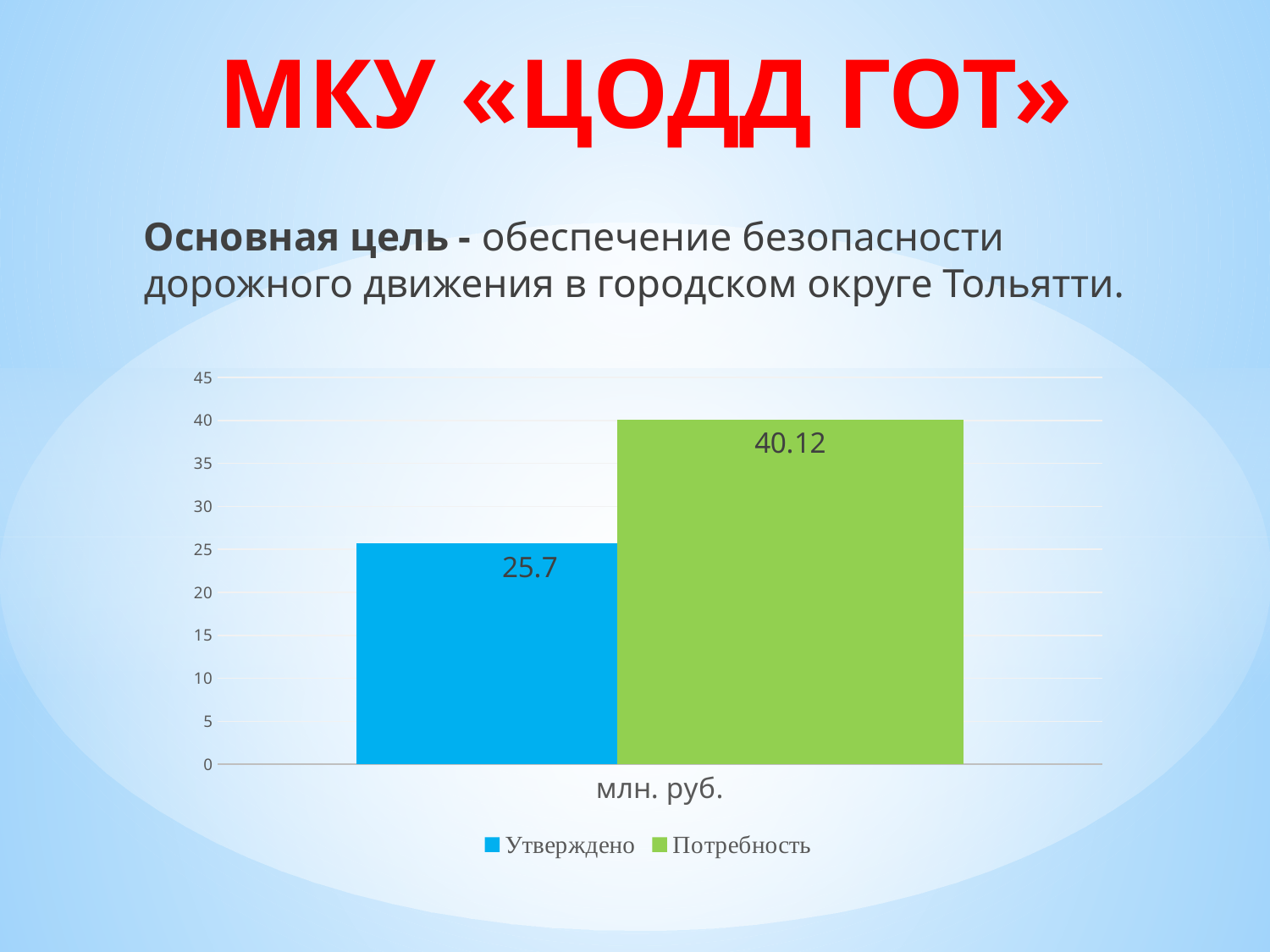
What is the label on the x axis under the bars? млн. руб. What is the value of the Потребность bar? 40.12 Is the value for Утверждено greater or less than 30? less What is the highest value shown on the y axis? 45 Which series has the lower value? Утверждено Which series has the higher value, Утверждено or Потребность? Потребность How many series does the legend list? 2 What kind of chart is shown on the slide? bar chart What is the difference between the Потребность and Утверждено values? 14.42 What colour is the Потребность bar? green Is the value for Потребность greater or less than 35? greater What is the value of the Утверждено bar? 25.7